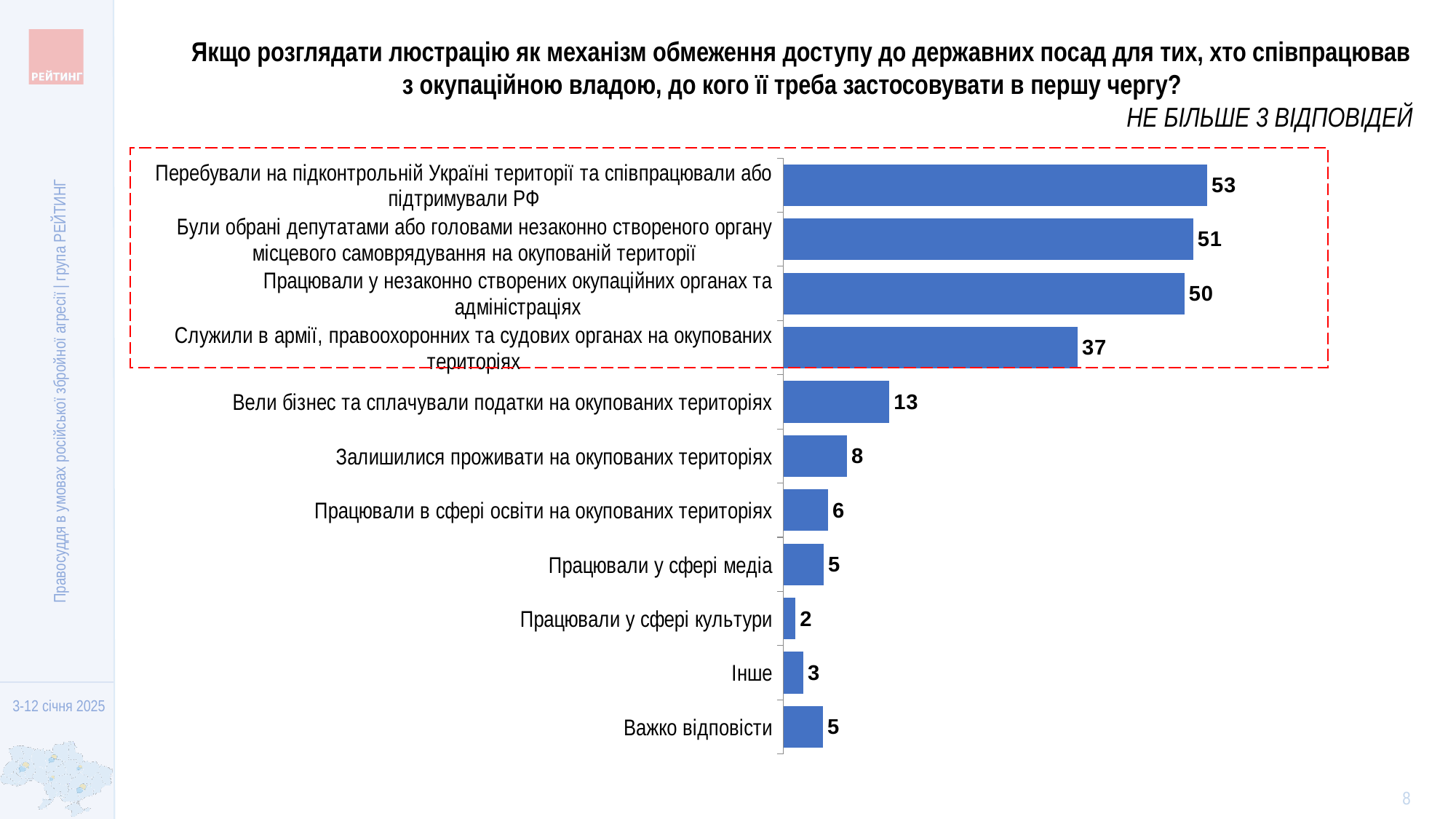
What is the difference between the values for "Перебували на підконтрольній Україні території та співпрацювали або підтримували РФ" and "Служили в армії, правоохоронних та судових органах на окупованих територіях"? 16 What value is shown for "Важко відповісти"? 5 What value is shown for "Вели бізнес та сплачували податки на окупованих територіях"? 13 Which category has the lowest value? Працювали у сфері культури How many categories are shown in the chart? 11 What kind of chart is shown on the slide? Bar chart Which is larger: the value for "Залишилися проживати на окупованих територіях" or for "Працювали в сфері освіти на окупованих територіях"? Залишилися проживати на окупованих територіях What value is shown for "Працювали у сфері культури"? 2 What is the difference between the values for "Були обрані депутатами або головами незаконно створеного органу місцевого самоврядування на окупованій території" and "Працювали у незаконно створених окупаційних органах та адміністраціях"? 1 Which category has the highest value? Перебували на підконтрольній Україні території та співпрацювали або підтримували РФ What value is shown for "Служили в армії, правоохоронних та судових органах на окупованих територіях"? 37 How many categories are enclosed in the red dashed box at the top of the chart? 4